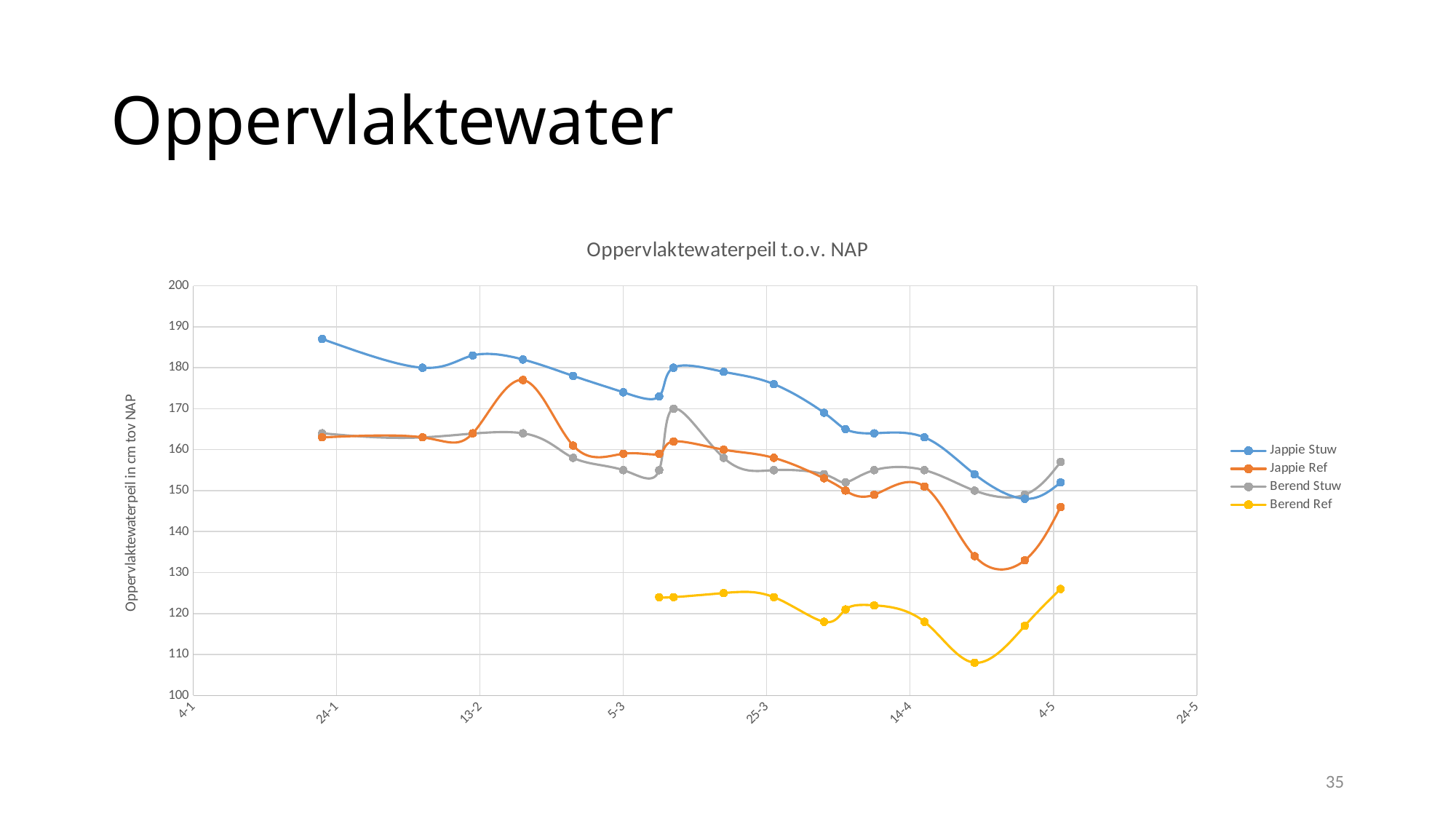
Does the Jappie Stuw series generally rise or fall from 24-1 to 4-5? fall How many series does the legend list? 4 How many date labels are shown on the x axis? 8 Which series has the lowest values across the chart? Berend Ref Is the highest plotted value for Jappie Ref greater or less than 170? greater Is the first plotted value for Jappie Stuw greater or less than 180? greater Which series has the highest values across the chart? Jappie Stuw Around 14-4, which series is higher: Jappie Stuw or Berend Ref? Jappie Stuw What is the title of the chart? Oppervlaktewaterpeil t.o.v. NAP What kind of chart is shown on the slide? line chart What is the label on the vertical axis of the chart? Oppervlaktewaterpeil in cm tov NAP Is the lowest plotted value for Berend Ref greater or less than 120? less